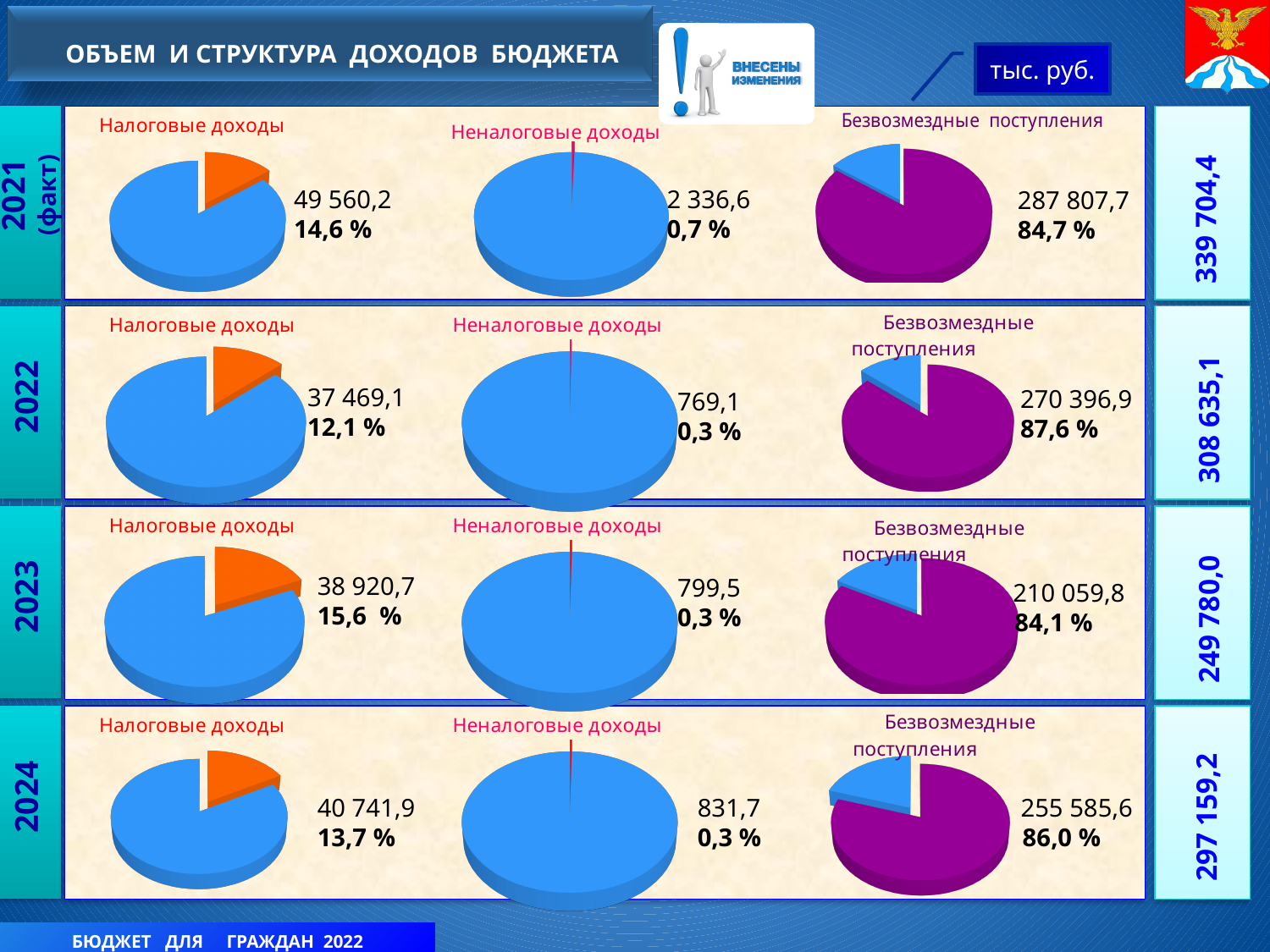
What is the difference between Неналоговые доходы in 2024 and Неналоговые доходы in 2023? 32,2 Which is larger: Налоговые доходы in 2021 (факт) or Налоговые доходы in 2024? 2021 (факт) In the 2024 row, what share is shown for Налоговые доходы? 13,7 % What kind of charts are shown on the slide? Pie charts In the 2024 row, what value is shown for Безвозмездные поступления? 255 585,6 In the 2023 row, what value is shown for Неналоговые доходы? 799,5 Which of the three income categories has the smallest value in the 2022 row? Неналоговые доходы Which of the three income categories has the largest value in the 2023 row? Безвозмездные поступления In the 2021 (факт) row, what value is shown for Налоговые доходы? 49 560,2 What total is shown on the right for the 2022 row? 308 635,1 How many pie charts are shown on the slide? 12 In the 2022 row, what share is shown for Безвозмездные поступления? 87,6 %